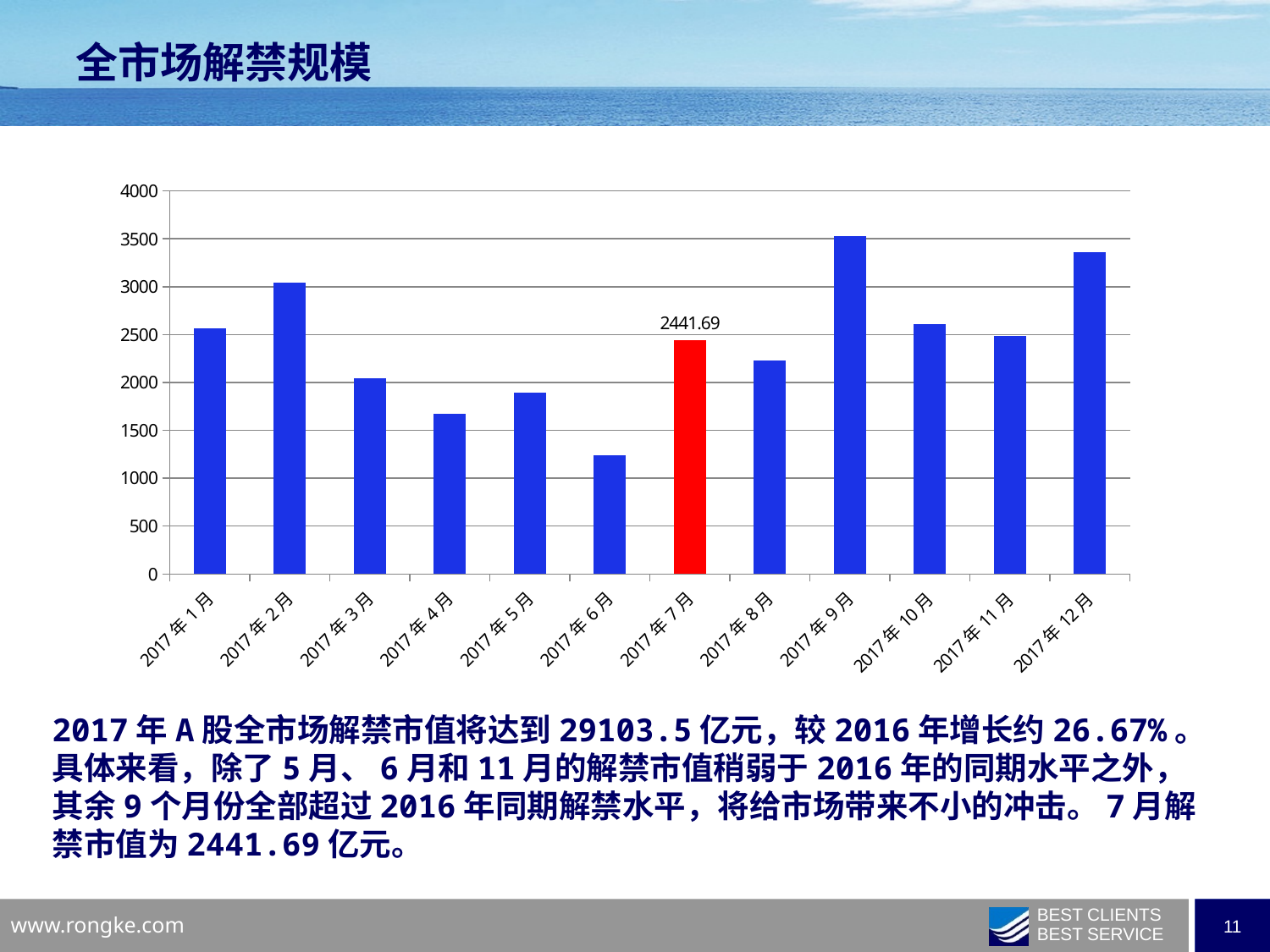
Is the value for 2017年4月 greater or less than 2000? less Which is larger, the value for 2017年2月 or 2017年1月? 2017年2月 What is the value for 2017年7月? 2441.69 Which is larger, the value for 2017年4月 or 2017年6月? 2017年4月 Is the value for 2017年6月 greater or less than 1500? less Which month has the highest bar? 2017年9月 Is the value for 2017年8月 greater or less than 2000? greater How many months are shown on the x axis? 12 Which month's bar is coloured red? 2017年7月 What kind of chart is shown on the slide? bar chart Which month has the lowest bar? 2017年6月